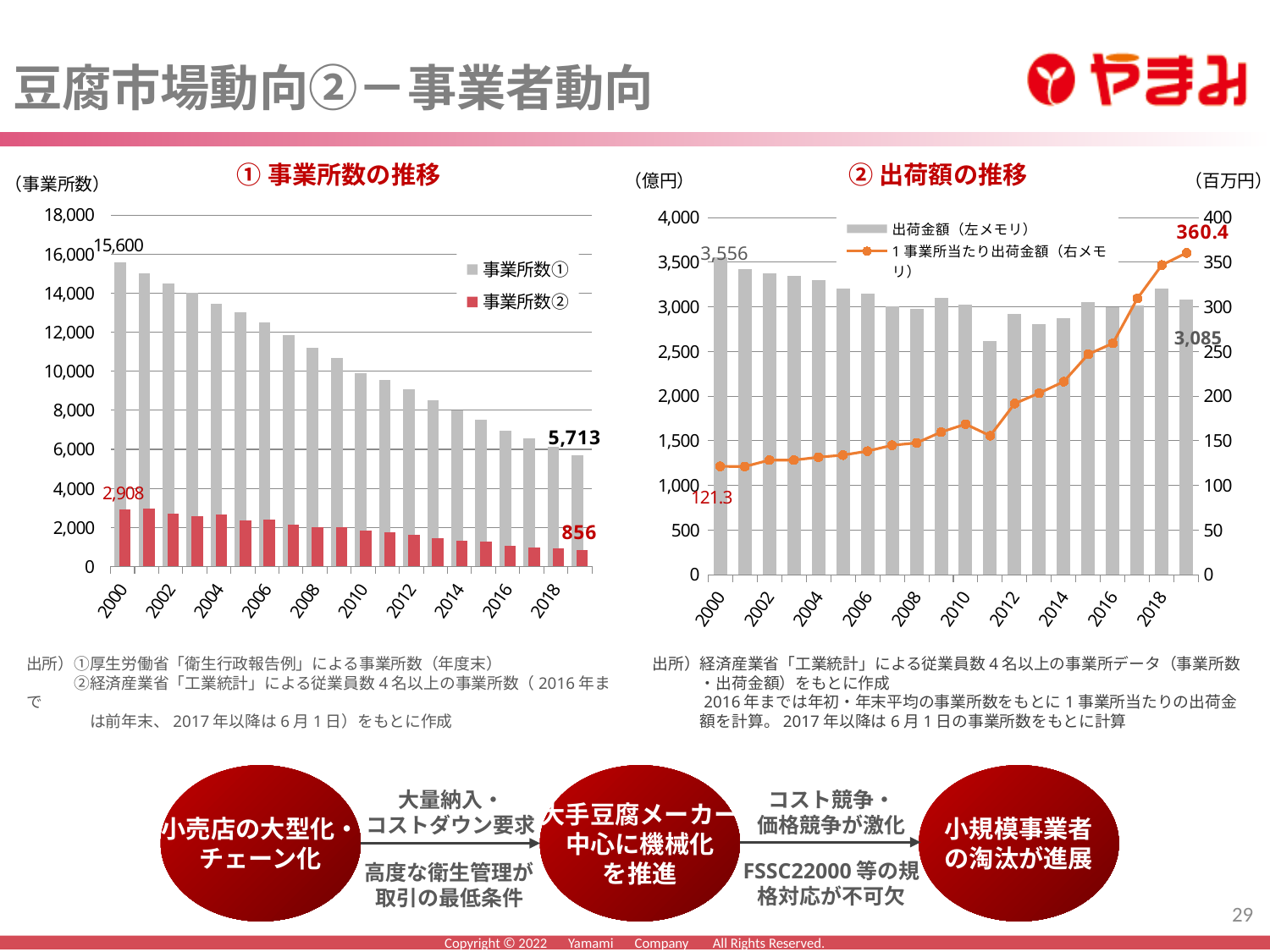
In the chart titled ② 出荷額の推移, does the 1事業所当たり出荷金額 line rise or fall over the years shown? rise In the chart titled ① 事業所数の推移, what is the value of 事業所数① for 2000? 15,600 In the chart titled ① 事業所数の推移, does 事業所数① rise or fall over the years shown? fall In the chart titled ② 出荷額の推移, what is the value of 出荷金額 for 2000? 3,556 In the chart titled ② 出荷額の推移, what is the value of 出荷金額 for the last year shown (2019)? 3,085 In the chart titled ① 事業所数の推移, what is the value of 事業所数② for the last year shown (2019)? 856 In the chart titled ① 事業所数の推移, by how much did 事業所数① fall from 2000 to 2019? 9,887 In the chart titled ② 出荷額の推移, what is the value of 1事業所当たり出荷金額 for the last year shown (2019)? 360.4 In the chart titled ① 事業所数の推移, how many series does the legend list? 2 In the chart titled ① 事業所数の推移, what is the value of 事業所数① for the last year shown (2019)? 5,713 In the chart titled ① 事業所数の推移, what is the value of 事業所数② for 2000? 2,908 In the chart titled ① 事業所数の推移, is the value of 事業所数① for 2010 greater or less than 8,000? greater